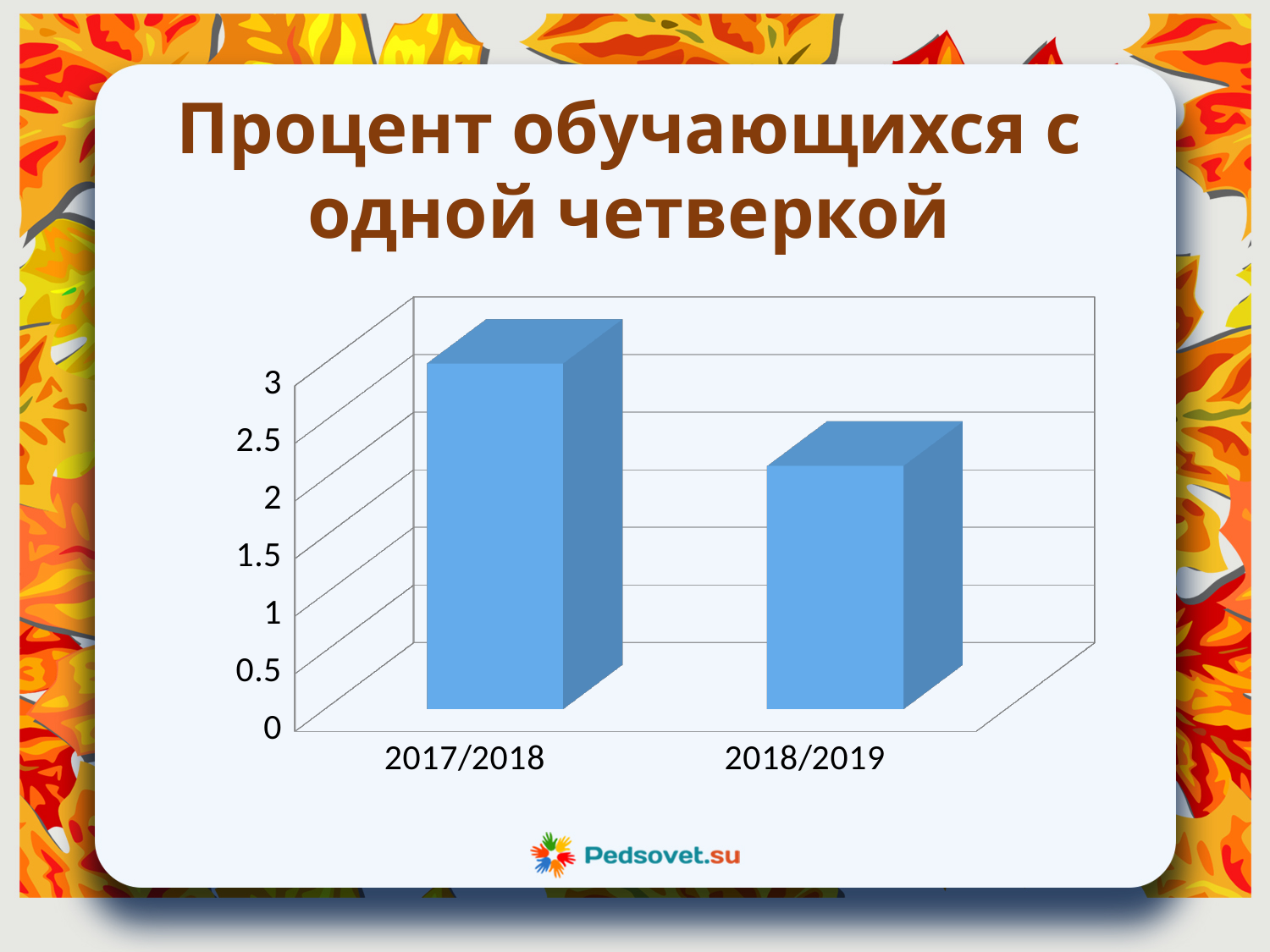
Is the value for 2018/2019 greater or less than 1? greater Which category has the lowest value? 2018/2019 How many categories are shown on the x axis of the chart? 2 What is the highest tick value shown on the vertical axis? 3 Which is larger, the value for 2017/2018 or the value for 2018/2019? 2017/2018 What kind of chart is shown on the slide? bar chart Do the values rise or fall from 2017/2018 to 2018/2019? fall What is the title of the chart? Процент обучающихся с одной четверкой Which category has the highest value? 2017/2018 Is the value for 2018/2019 greater or less than 2.5? less Is the value for 2017/2018 greater or less than 2.5? greater